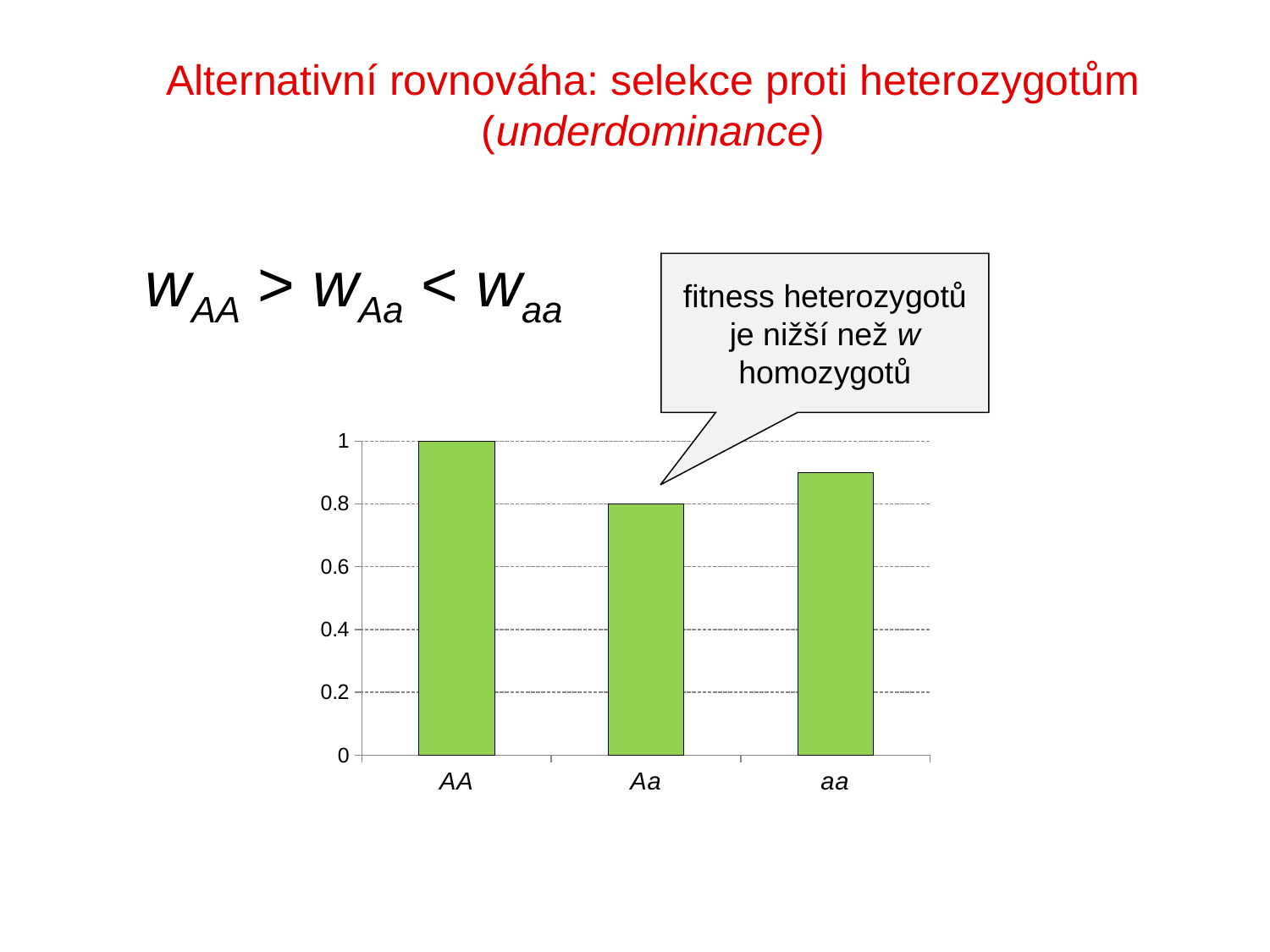
Is the value for aa greater or less than 0.8? greater Which is larger, the value for AA or the value for aa? AA Which category has the highest value? AA What kind of chart is shown on the slide? bar chart How many categories are shown on the x axis? 3 Is the value for aa greater or less than 1? less Which category has the lowest value? Aa What is the value for AA? 1 What is the difference between the values for AA and Aa? 0.2 What colour are the bars in the chart? green